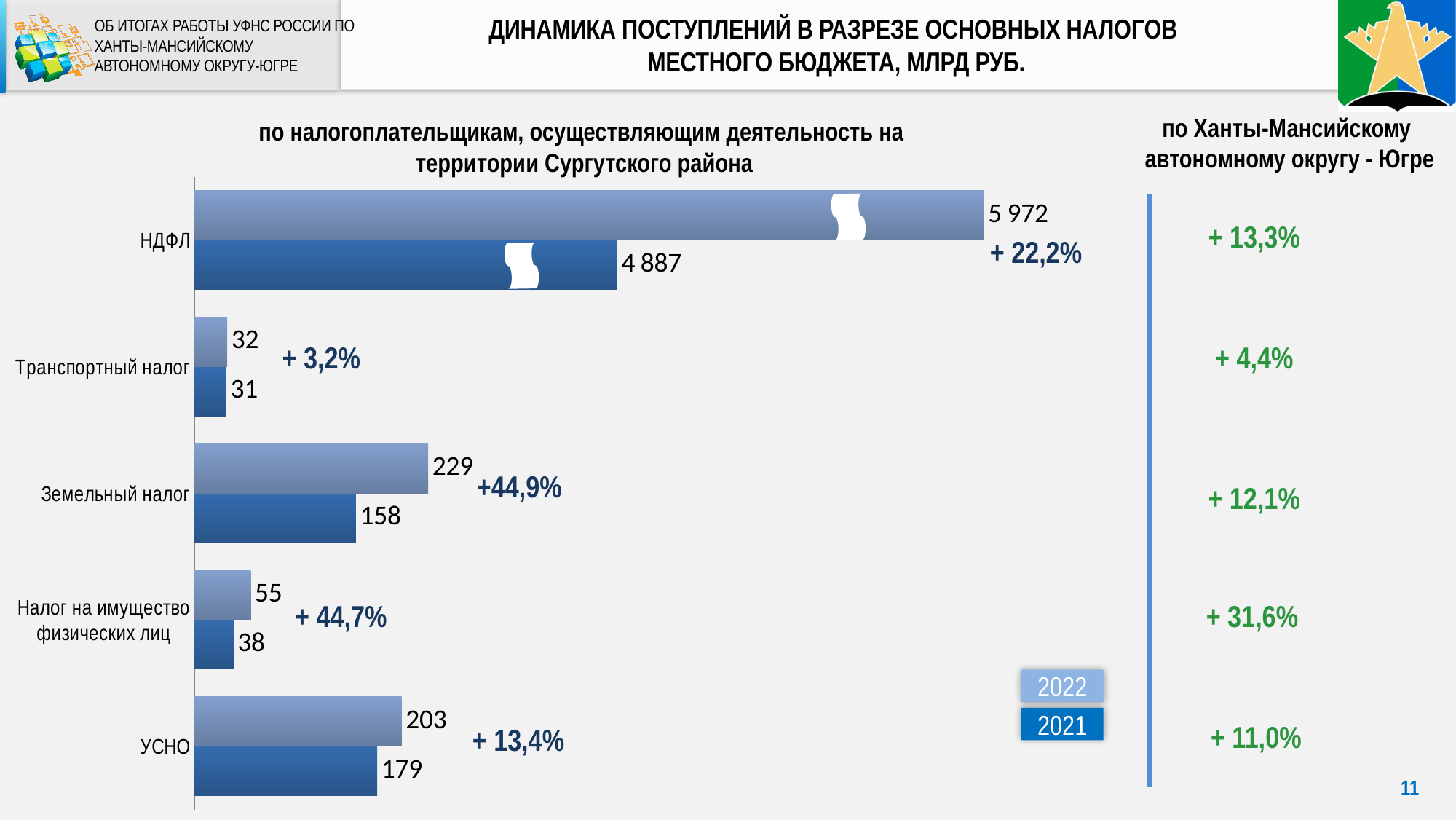
Which category has the lowest value in 2021? Транспортный налог What is the value for НДФЛ in 2022? 5 972 What is the value for УСНО in 2021? 179 Which category has the highest value in 2022? НДФЛ What kind of chart is shown on the slide? Bar chart What is the value for НДФЛ in 2021? 4 887 How many tax categories are shown in the chart? 5 How many series does the legend list? 2 What is the value for Земельный налог in 2022? 229 What growth percentage is shown next to the bars for Налог на имущество физических лиц? + 44,7% Which is larger in 2022: Земельный налог or УСНО? Земельный налог What is the difference between the 2022 and 2021 values for Земельный налог? 71